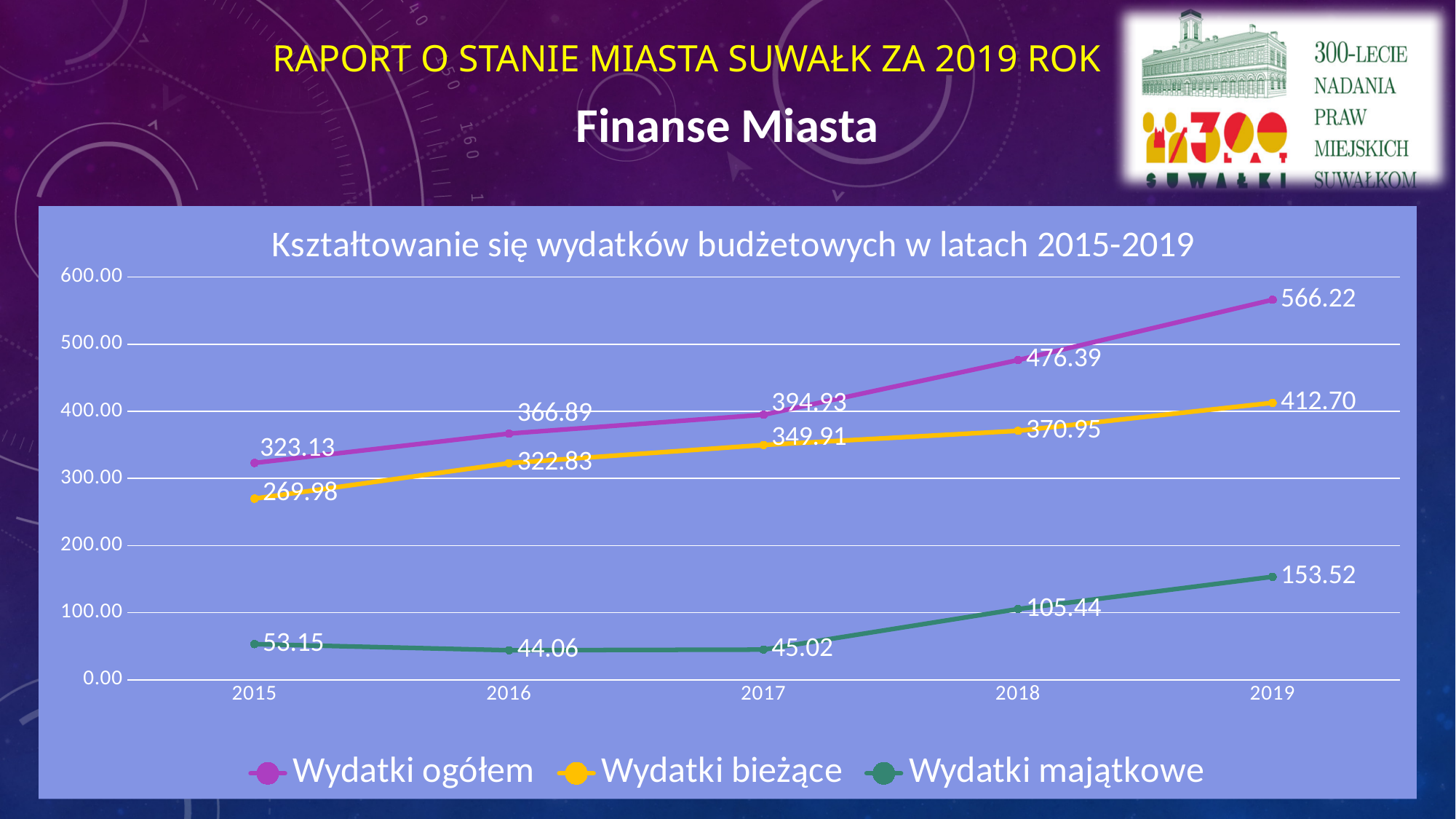
What is the title of the chart? Kształtowanie się wydatków budżetowych w latach 2015-2019 Does Wydatki bieżące rise or fall from 2015 to 2019? rise What type of chart is shown on the slide? line chart In which year is Wydatki majątkowe lowest? 2016 What is the value of Wydatki ogółem in 2019? 566.22 Which is larger: Wydatki bieżące in 2017 or Wydatki ogółem in 2015? Wydatki bieżące in 2017 What is the value of Wydatki majątkowe in 2018? 105.44 How many years are shown on the x axis? 5 In which year is Wydatki ogółem highest? 2019 How many series does the legend list? 3 What is the value of Wydatki bieżące in 2016? 322.83 What is the difference between Wydatki ogółem and Wydatki bieżące in 2019? 153.52